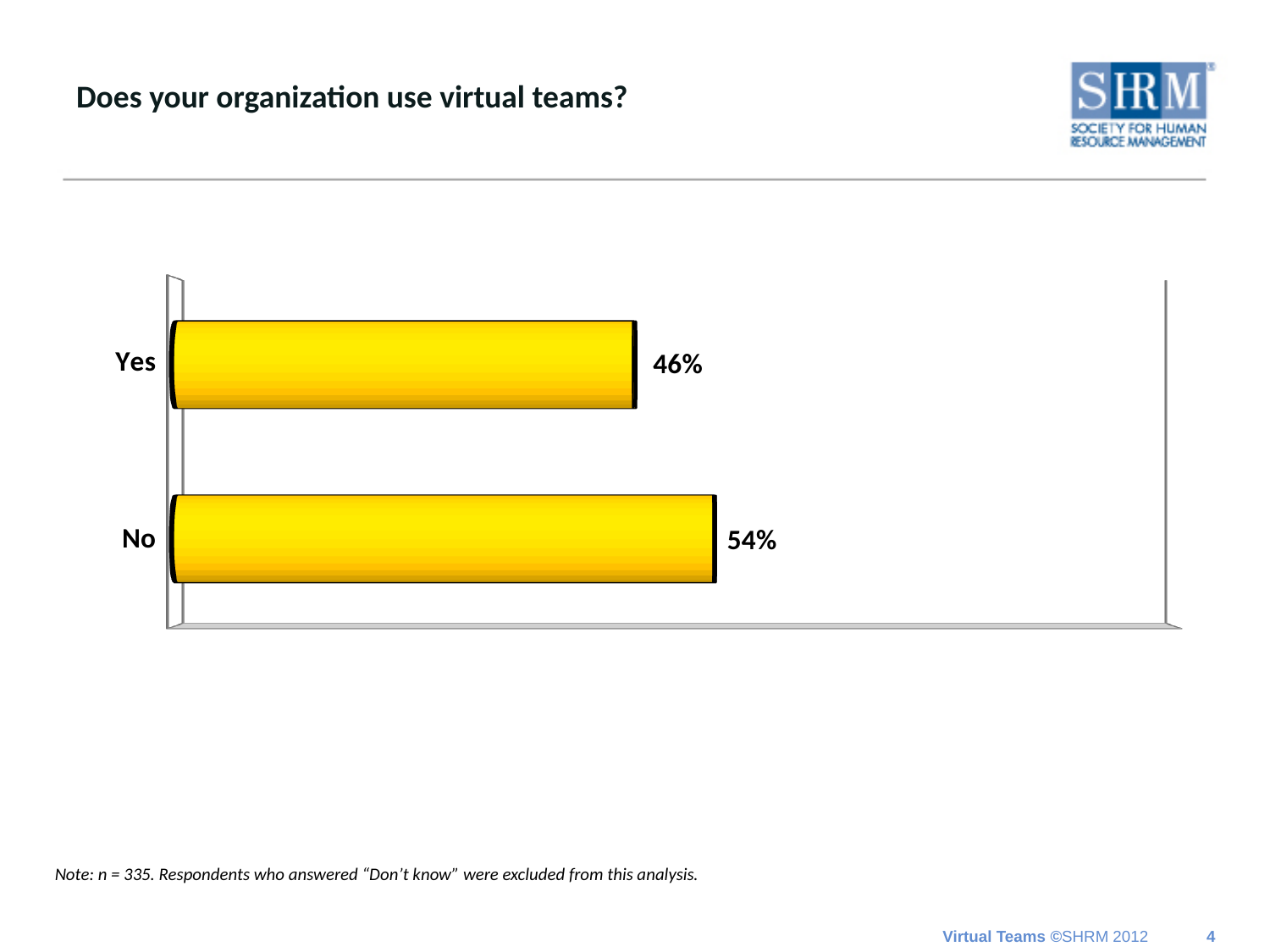
Is the value for Yes larger or smaller than the value for No? smaller Which response has the lower percentage, Yes or No? Yes What type of chart is used on this slide? bar chart What question does the chart on this slide address? Does your organization use virtual teams? What is the combined total of the Yes and No percentages? 100% What colour are the bars in the chart? yellow How many response categories are shown in the chart? 2 What percentage of respondents answered "No" to whether their organization uses virtual teams? 54% What percentage of respondents answered "Yes" to whether their organization uses virtual teams? 46% What is the difference in percentage points between the No and Yes responses? 8 percentage points Which response has the higher percentage, Yes or No? No